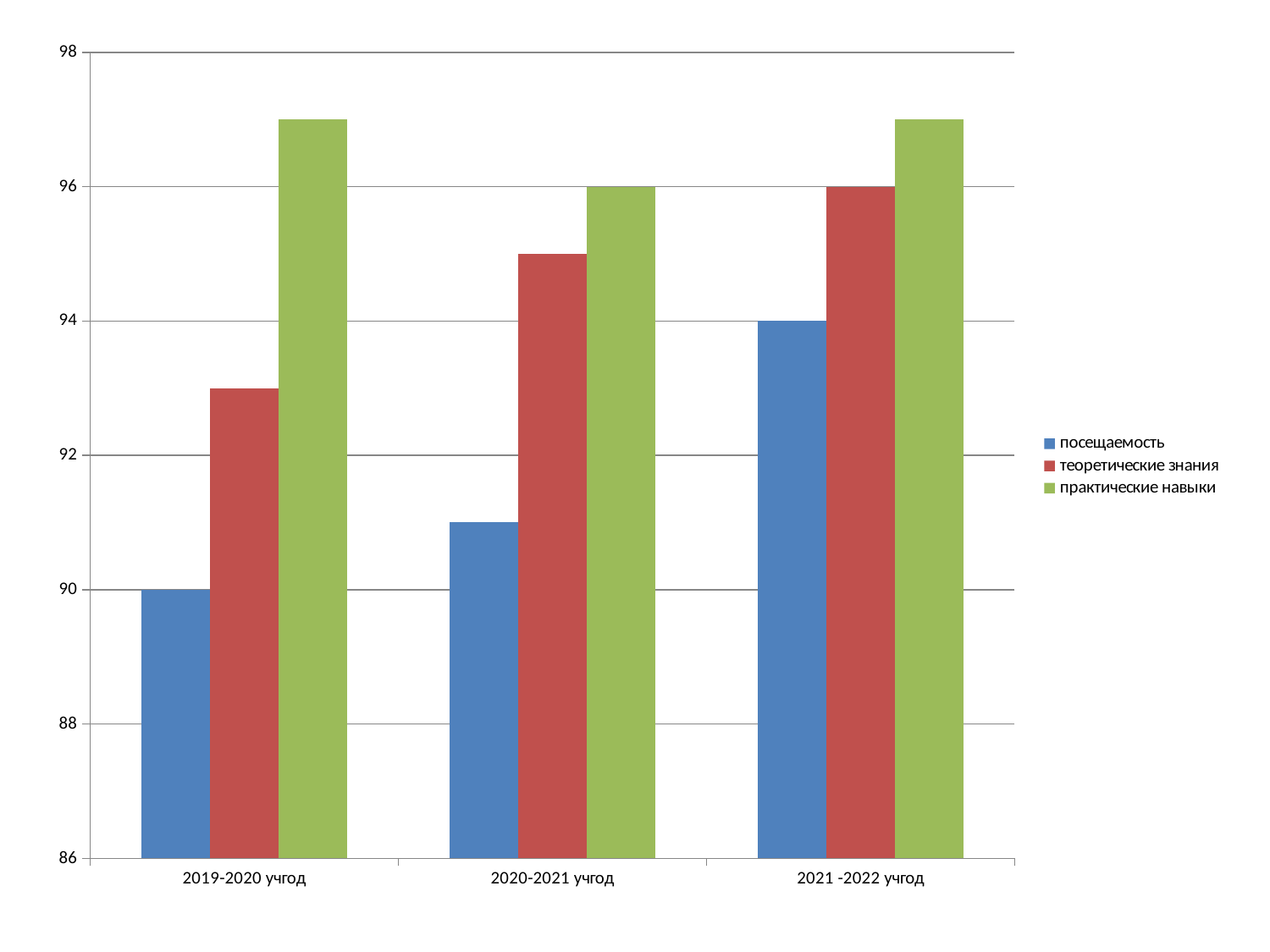
Is the value of теоретические знания for 2019-2020 учгод greater or less than 92? greater Which series has the lowest value for 2020-2021 учгод? посещаемость What is the value of теоретические знания for 2021 -2022 учгод? 96 What kind of chart is shown on the slide? bar chart What is the value of посещаемость for 2019-2020 учгод? 90 Which series has the highest value for 2019-2020 учгод? практические навыки What is the value of практические навыки for 2020-2021 учгод? 96 Does посещаемость rise or fall from 2019-2020 учгод to 2021 -2022 учгод? rise Is the value of практические навыки for 2019-2020 учгод greater or less than 96? greater What is the difference between посещаемость in 2021 -2022 учгод and посещаемость in 2019-2020 учгод? 4 How many series does the legend list? 3 What is the value of посещаемость for 2021 -2022 учгод? 94